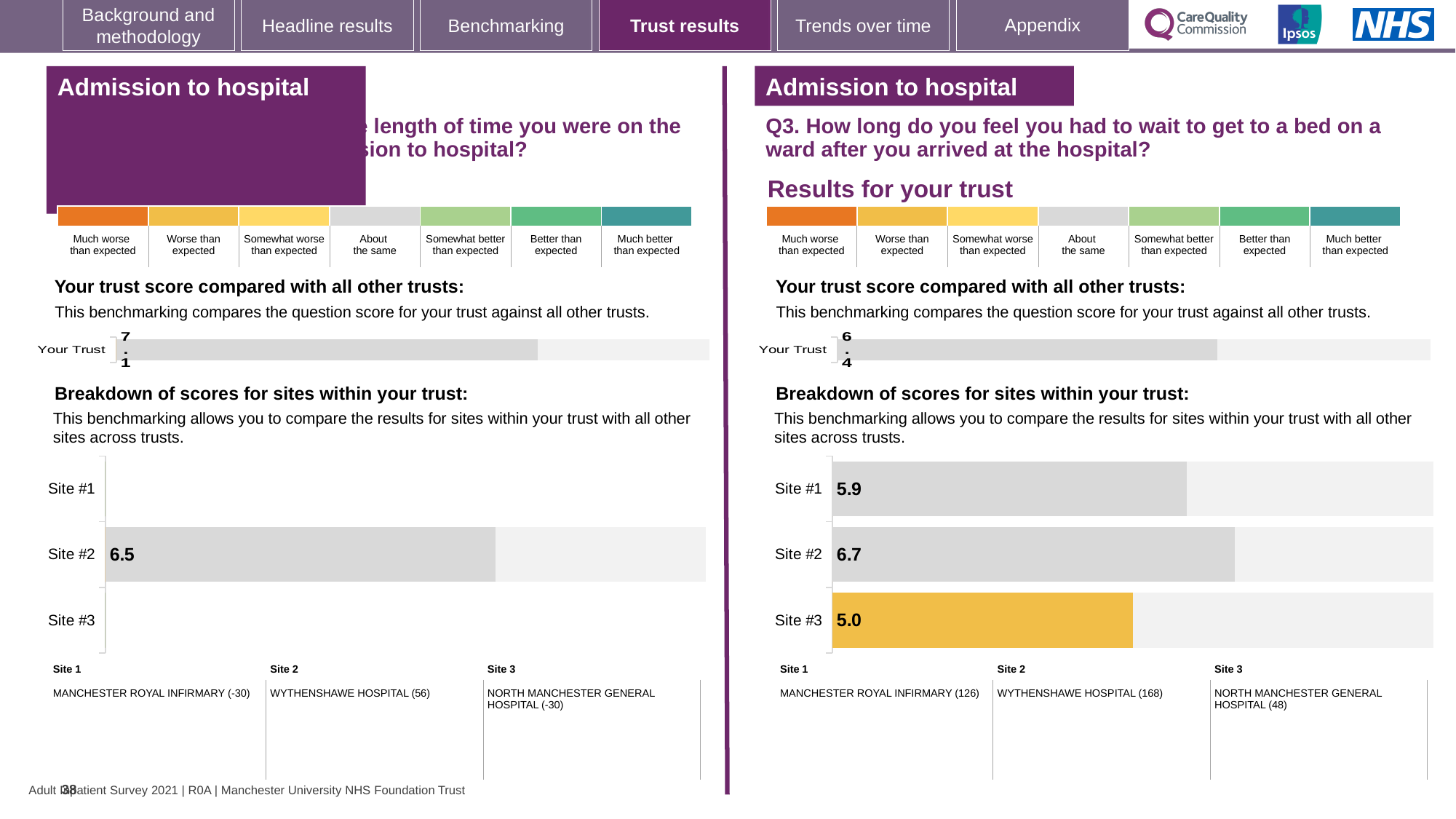
On the right-hand chart (Q3, breakdown of scores for sites within your trust), what is the difference between the scores for Site #2 and Site #1? 0.8 On the right-hand chart (Q3, breakdown of scores for sites within your trust), what is the score for Site #1? 5.9 On the right-hand chart (Q3, breakdown of scores for sites within your trust), which site has the highest score? Site #2 On the right-hand chart (Q3, breakdown of scores for sites within your trust), what is the score for Site #3? 5.0 Which is larger: the 'Your Trust' score on the left-hand side of the slide or the 'Your Trust' score on the right-hand side (Q3)? The left-hand side (7.1) On the right-hand chart (Q3, breakdown of scores for sites within your trust), how many sites are shown? 3 On the right-hand side of the slide (Q3), what is the 'Your Trust' score shown in the trust benchmarking bar? 6.4 On the right-hand chart (Q3, breakdown of scores for sites within your trust), which site has the lowest score? Site #3 On the right-hand chart (Q3, breakdown of scores for sites within your trust), what is the difference between the scores for Site #2 and Site #3? 1.7 On the left-hand chart (breakdown of scores for sites within your trust), what is the score for Site #2? 6.5 What type of chart is used for the breakdown of scores for sites within your trust on the right-hand side (Q3)? Bar chart On the left-hand side of the slide, what is the 'Your Trust' score shown in the trust benchmarking bar? 7.1